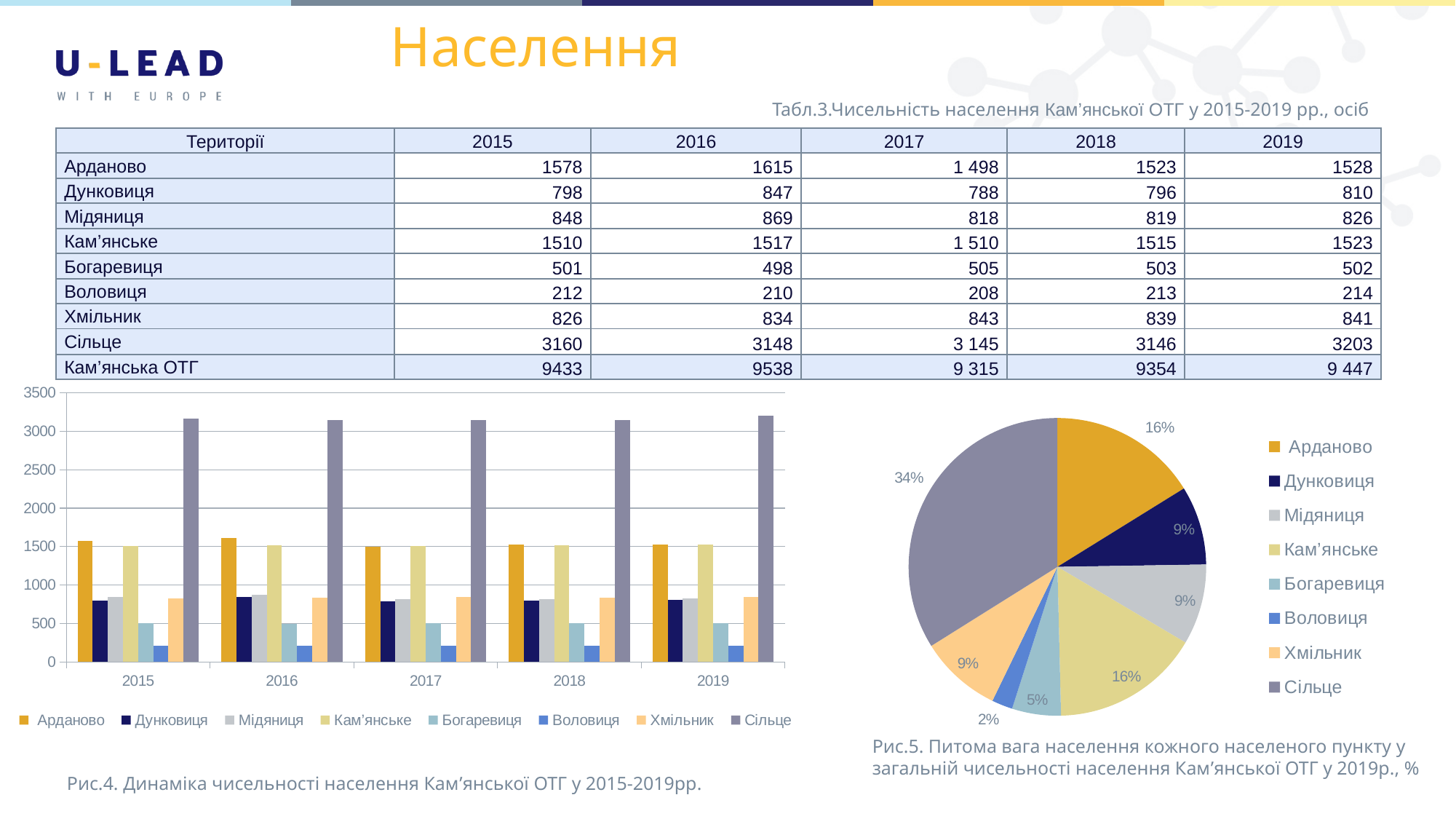
In the bar chart (Рис.4), which territory has the lowest bar in 2017? Воловиця In the bar chart (Рис.4), which territory has the highest bar in 2019? Сільце In the bar chart (Рис.4), how many year categories are shown on the x axis? 5 In the bar chart (Рис.4), how many series does the legend list? 8 In the bar chart (Рис.4), is the value for Сільце in 2019 greater or less than 3000? greater In the pie chart (Рис.5), what is the difference between the shares of Сільце and Арданово? 18% In the pie chart (Рис.5), which territory has the smallest slice? Воловиця What kind of chart is Рис.4 on the left of the slide? bar chart In the bar chart (Рис.4), is the value for Богаревиця in 2017 greater or less than 1000? less What kind of chart is Рис.5 on the right of the slide? pie chart In the bar chart (Рис.4), which is larger in 2018: Хмільник or Богаревиця? Хмільник In the pie chart (Рис.5), what share does Сільце have? 34%